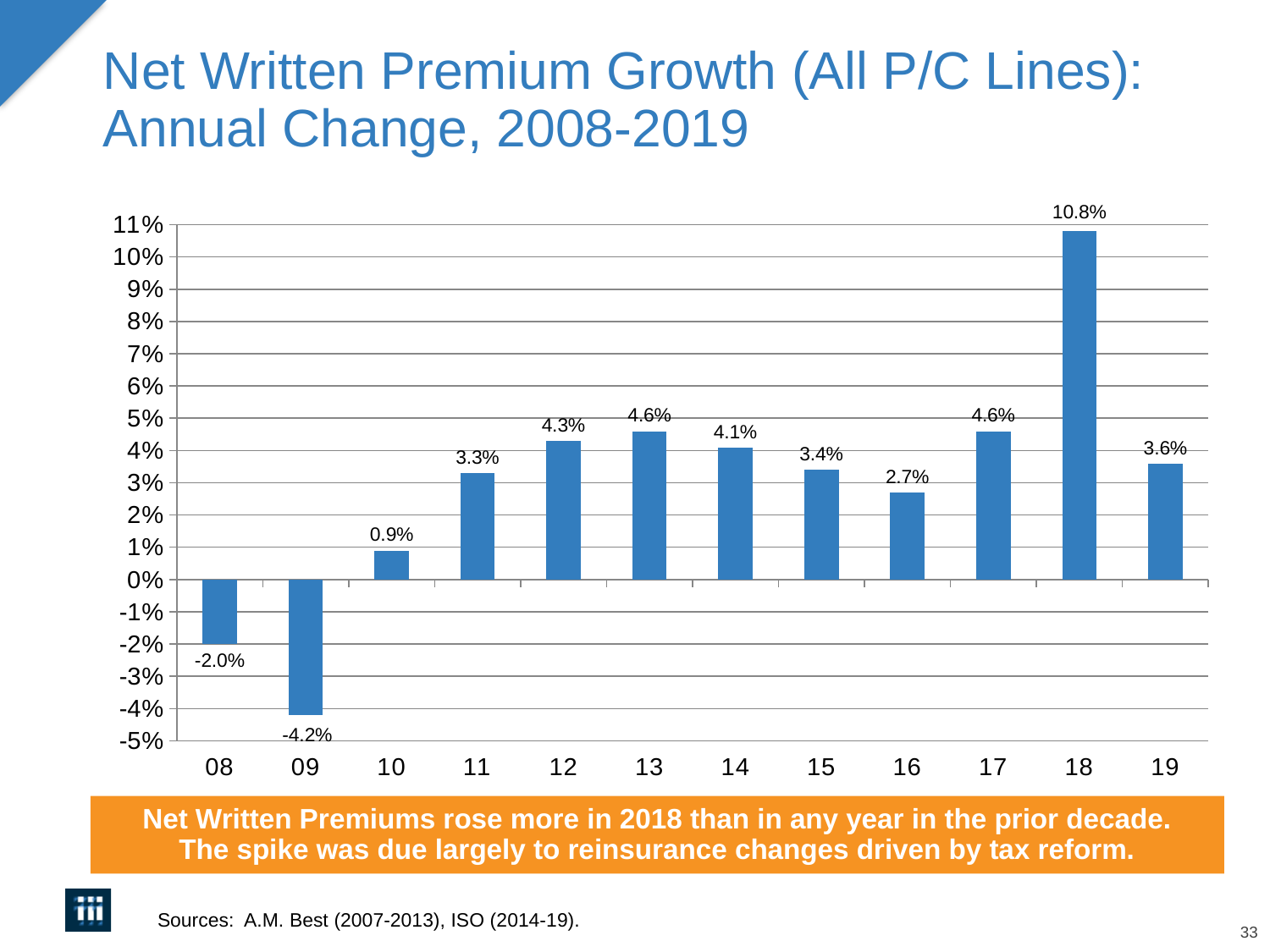
What is the value shown for 2016? 2.7% What is the title of the chart? Net Written Premium Growth (All P/C Lines): Annual Change, 2008-2019 Do the values rise or fall from 2008 to 2010? fall then rise How many years are shown on the x axis? 12 What kind of chart is this? bar chart What is the difference between the values for 2018 and 2019? 7.2% Is the value for 2010 greater or less than 1%? less What is the net written premium growth value for 2018? 10.8% Which year has the larger value, 2012 or 2015? 12 Which year has the highest net written premium growth? 18 What is the value shown for 2009? -4.2% Which year has the lowest net written premium growth? 09